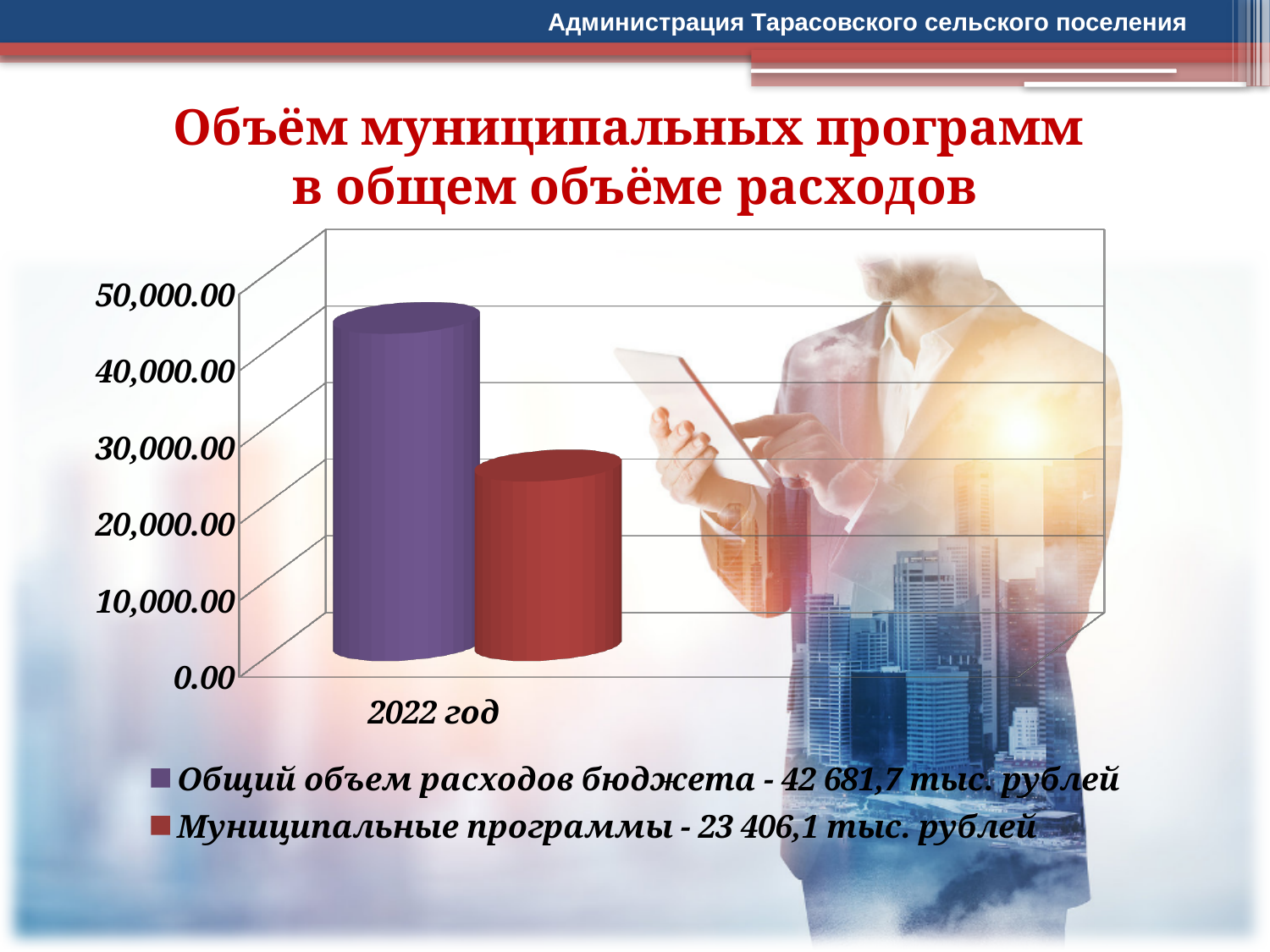
How many series does the chart legend list? 2 What type of chart is shown on the slide? bar chart What is the difference between Общий объем расходов бюджета and Муниципальные программы? 19 275,6 тыс. рублей What is the value for Общий объем расходов бюджета according to the legend? 42 681,7 тыс. рублей Which series has the lowest value on the chart? Муниципальные программы Which series has the higher value, Общий объем расходов бюджета or Муниципальные программы? Общий объем расходов бюджета What is the value for Муниципальные программы according to the legend? 23 406,1 тыс. рублей What is the title of the chart on the slide? Объём муниципальных программ в общем объёме расходов Which year is shown on the x axis of the chart? 2022 год Is the value for Муниципальные программы greater or less than 30,000.00? less How many categories are shown on the x axis of the chart? 1 Is the value for Общий объем расходов бюджета greater or less than 40,000.00? greater